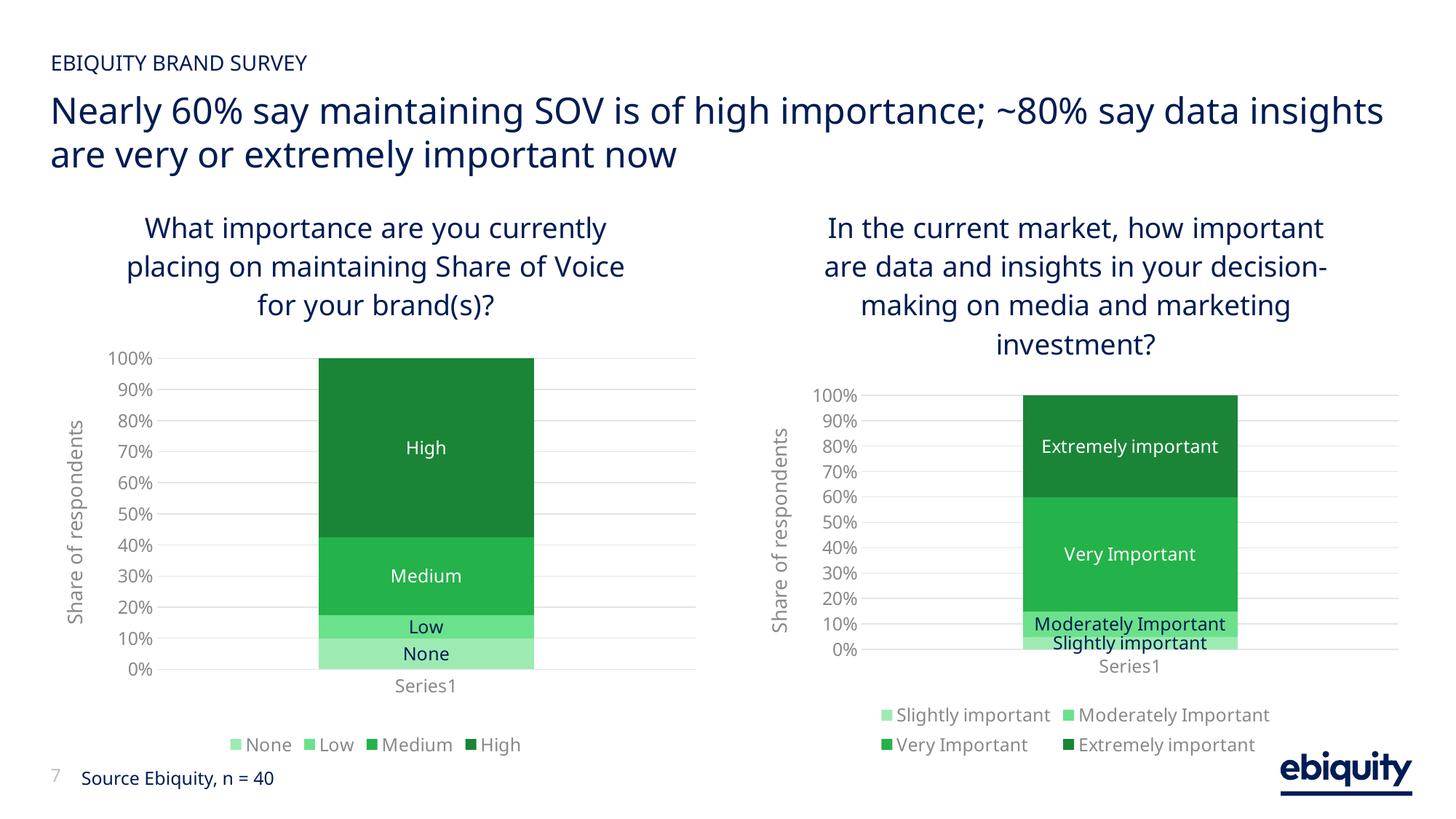
How many series does the legend of the right chart (importance of data and insights) list? 4 In the left chart (Share of Voice importance), which segment is the largest? High In the left chart (Share of Voice importance), which segment is the smallest? Low What is the y-axis label on the left chart (Share of Voice importance)? Share of respondents In the right chart (importance of data and insights), which segment is larger: "Moderately Important" or "Slightly important"? Moderately Important In the left chart (Share of Voice importance), which segment is larger: "Medium" or "None"? Medium In the left chart (Share of Voice importance), is the share for "High" greater or less than 50%? greater In the right chart (importance of data and insights), is the share for "Very Important" greater or less than 40%? greater What kind of chart is the left chart, titled "What importance are you currently placing on maintaining Share of Voice for your brand(s)?"? Stacked bar chart How many series does the legend of the left chart (Share of Voice importance) list? 4 In the right chart (importance of data and insights), which segment is the smallest? Slightly important In the left chart (Share of Voice importance), is the share for "Medium" greater or less than 30%? less